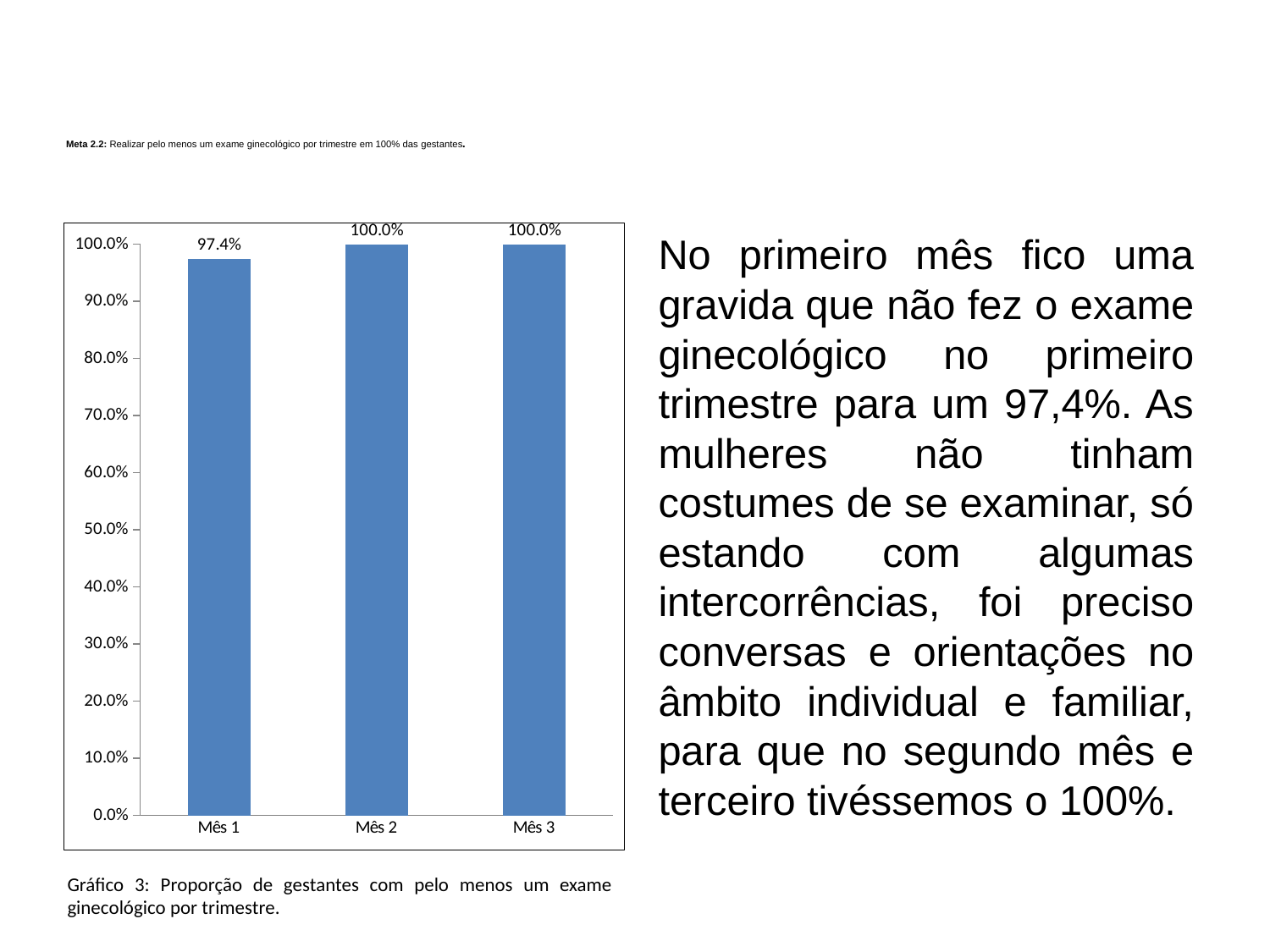
What is the highest value shown on the y axis? 100.0% Which is larger, the value for Mês 1 or the value for Mês 3? Mês 3 What is the value for Mês 1? 97.4% What is the value for Mês 3? 100.0% What is the difference between the values for Mês 2 and Mês 1? 2.6% Which month has the lowest value? Mês 1 What is the value for Mês 2? 100.0% Do the values rise or fall from Mês 1 to Mês 2? rise What kind of chart is shown? bar chart How many months are shown on the x axis? 3 What colour are the bars? blue Is the value for Mês 1 greater or less than 90.0%? greater